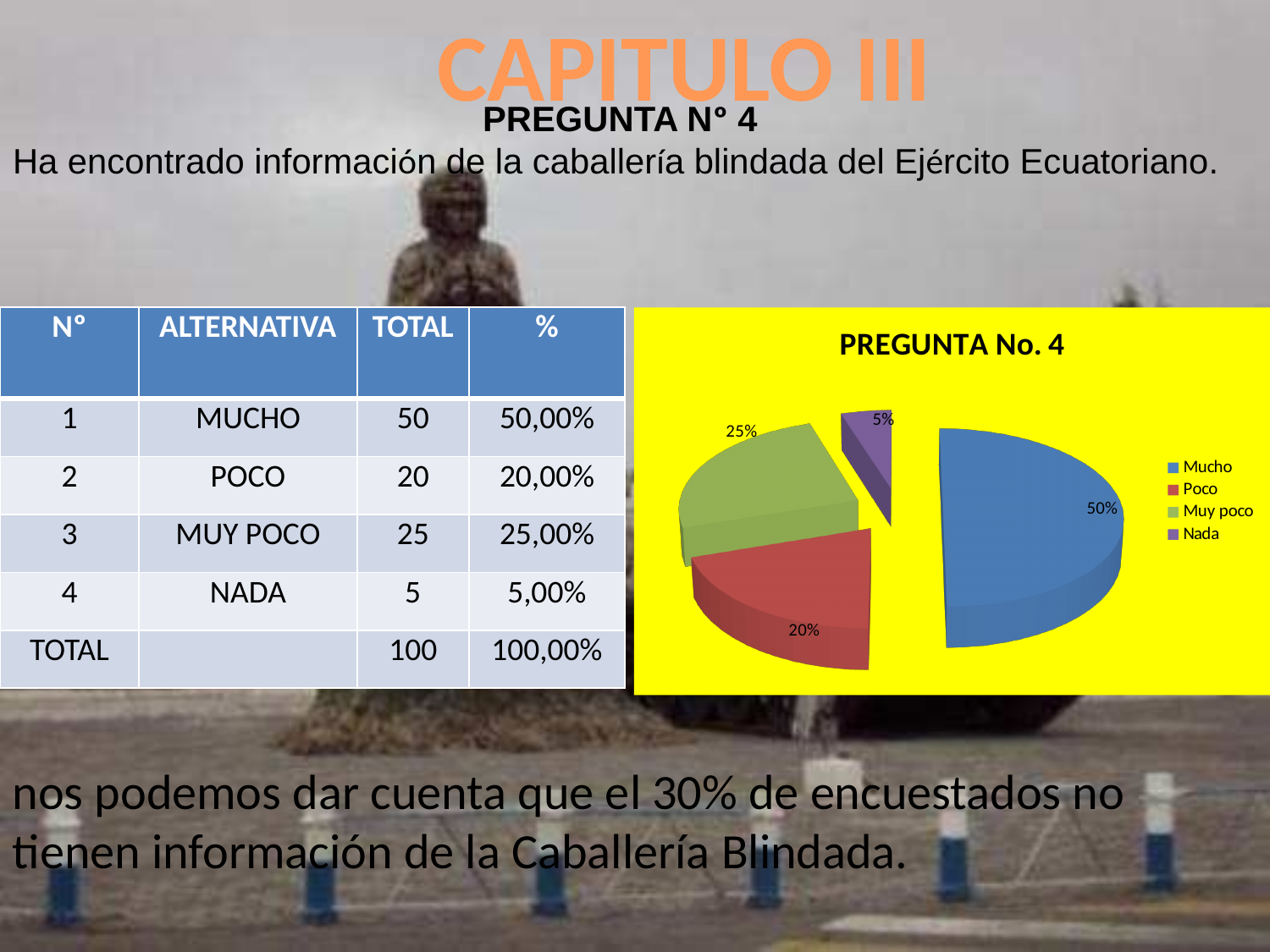
What percentage does the Mucho slice show in the pie chart? 50% What percentage does the Poco slice show in the pie chart? 20% What type of chart is shown on the slide? pie chart What percentage does the Nada slice show in the pie chart? 5% Which category has the smallest slice in the pie chart? Nada Which slice is larger, Muy poco or Poco? Muy poco What is the title of the chart? PREGUNTA No. 4 Which category has the largest slice in the pie chart? Mucho How many categories does the legend of the pie chart list? 4 What colour is the Mucho slice in the pie chart? blue What percentage does the Muy poco slice show in the pie chart? 25% What is the difference in percentage points between the Mucho and Poco slices? 30